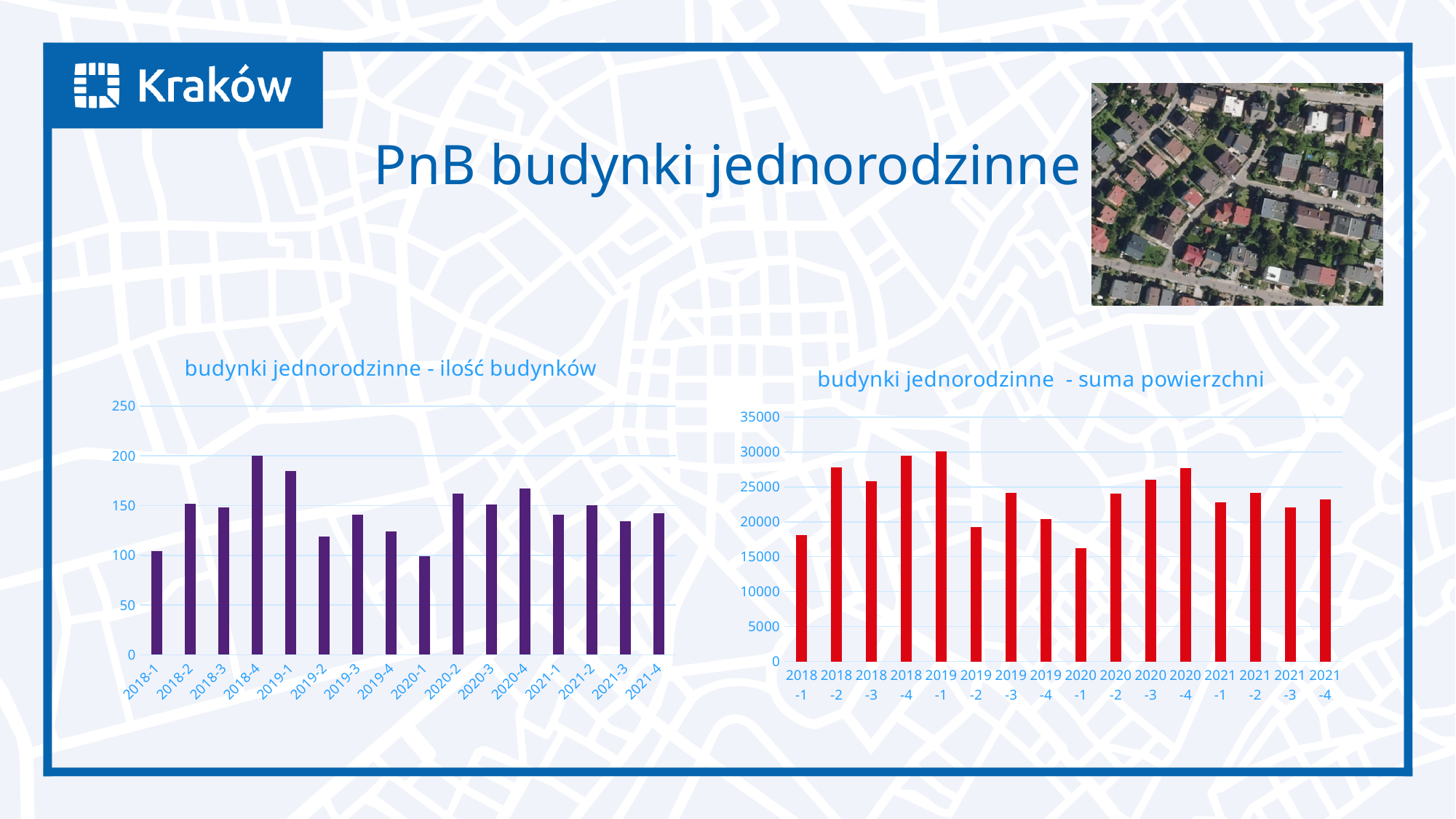
On the left chart, 'budynki jednorodzinne - ilość budynków', which quarter has the highest value? 2018-4 On the left chart, 'budynki jednorodzinne - ilość budynków', which is larger, the value for 2018-4 or the value for 2019-2? 2018-4 On the right chart, 'budynki jednorodzinne - suma powierzchni', is the value for 2019-1 greater or less than 25000? greater On the left chart, 'budynki jednorodzinne - ilość budynków', is the value for 2018-1 greater or less than 150? less How many quarters (categories) are plotted on the left chart, 'budynki jednorodzinne - ilość budynków'? 16 What kind of chart is the left chart, 'budynki jednorodzinne - ilość budynków'? bar chart On the right chart, 'budynki jednorodzinne - suma powierzchni', which is larger, the value for 2018-2 or the value for 2019-2? 2018-2 On the right chart, 'budynki jednorodzinne - suma powierzchni', which quarter has the lowest value? 2020-1 On the right chart, 'budynki jednorodzinne - suma powierzchni', is the value for 2018-1 greater or less than 20000? less How many quarters (categories) are plotted on the right chart, 'budynki jednorodzinne - suma powierzchni'? 16 What colour are the bars on the right chart, 'budynki jednorodzinne - suma powierzchni'? red